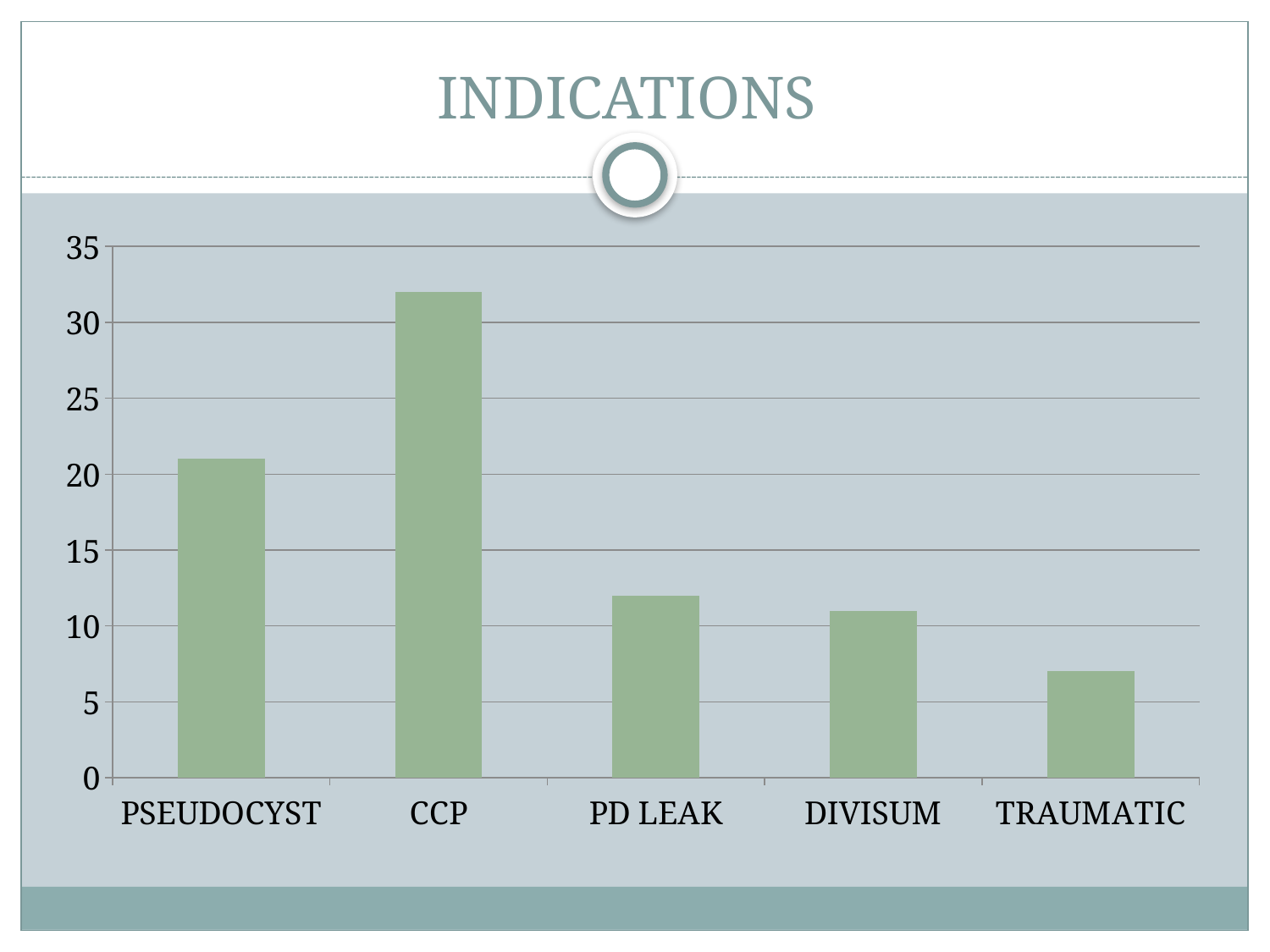
Is the value for DIVISUM greater or less than 10? greater Is the value for PD LEAK greater or less than 15? less Which category has the lowest bar? TRAUMATIC Is the value for PSEUDOCYST greater or less than 20? greater Which is larger, the value for DIVISUM or the value for TRAUMATIC? DIVISUM What kind of chart is shown on the slide? bar chart What is the title of the slide? INDICATIONS How many categories are shown on the x axis? 5 Which category has the highest bar? CCP Which is larger, the value for PSEUDOCYST or the value for PD LEAK? PSEUDOCYST